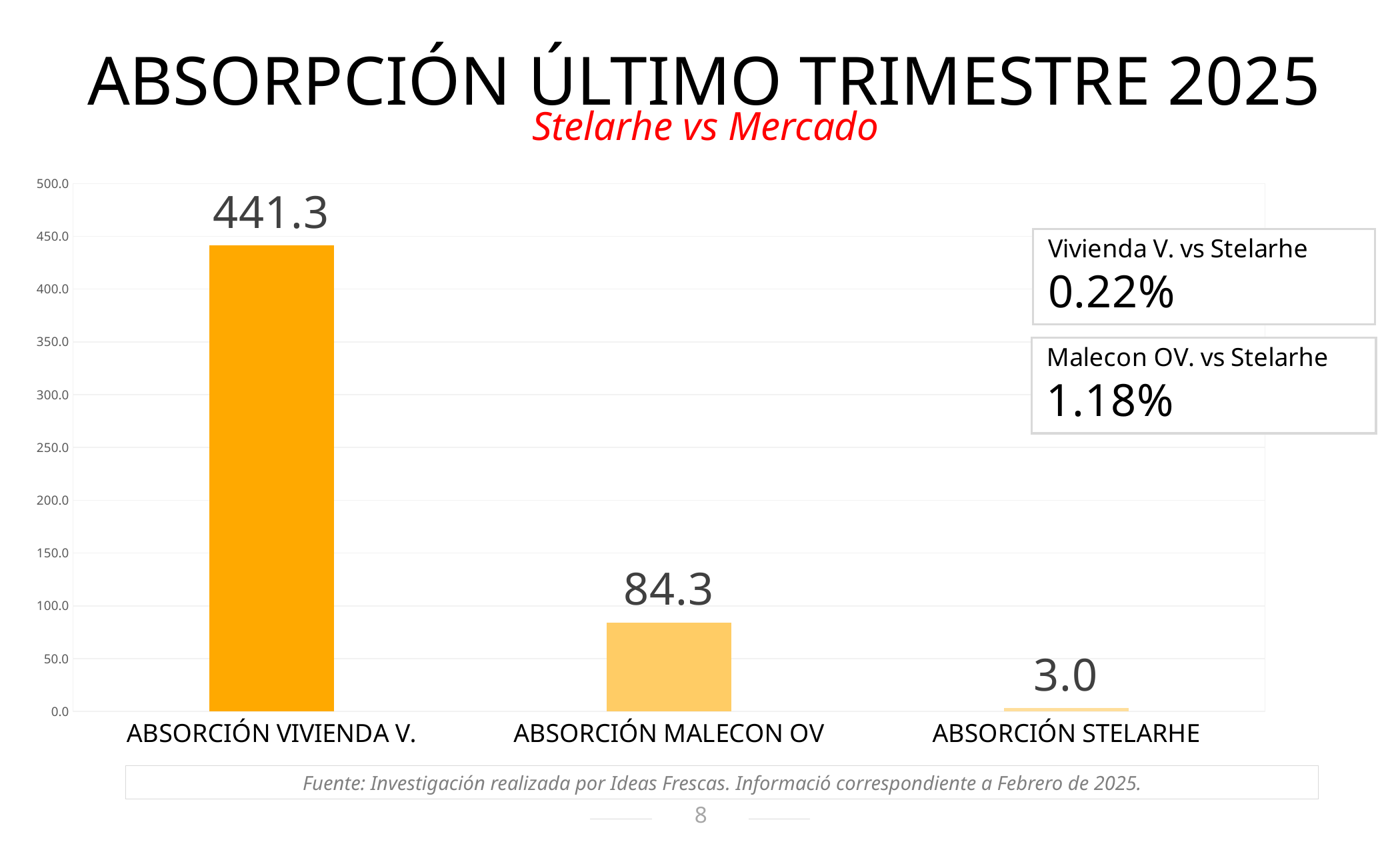
What percentage is shown in the box labelled 'Malecon OV. vs Stelarhe'? 1.18% What is the value for ABSORCIÓN STELARHE? 3.0 What is the difference between the values for ABSORCIÓN MALECON OV and ABSORCIÓN STELARHE? 81.3 Is the value for ABSORCIÓN VIVIENDA V. greater or less than 400.0? greater What is the value for ABSORCIÓN MALECON OV? 84.3 How many categories are shown in the chart? 3 What is the difference between the values for ABSORCIÓN VIVIENDA V. and ABSORCIÓN MALECON OV? 357.0 Which category has the lowest value? ABSORCIÓN STELARHE What kind of chart is shown on the slide? bar chart Which is larger, the value for ABSORCIÓN MALECON OV or ABSORCIÓN STELARHE? ABSORCIÓN MALECON OV What is the value for ABSORCIÓN VIVIENDA V.? 441.3 Which category has the highest value? ABSORCIÓN VIVIENDA V.